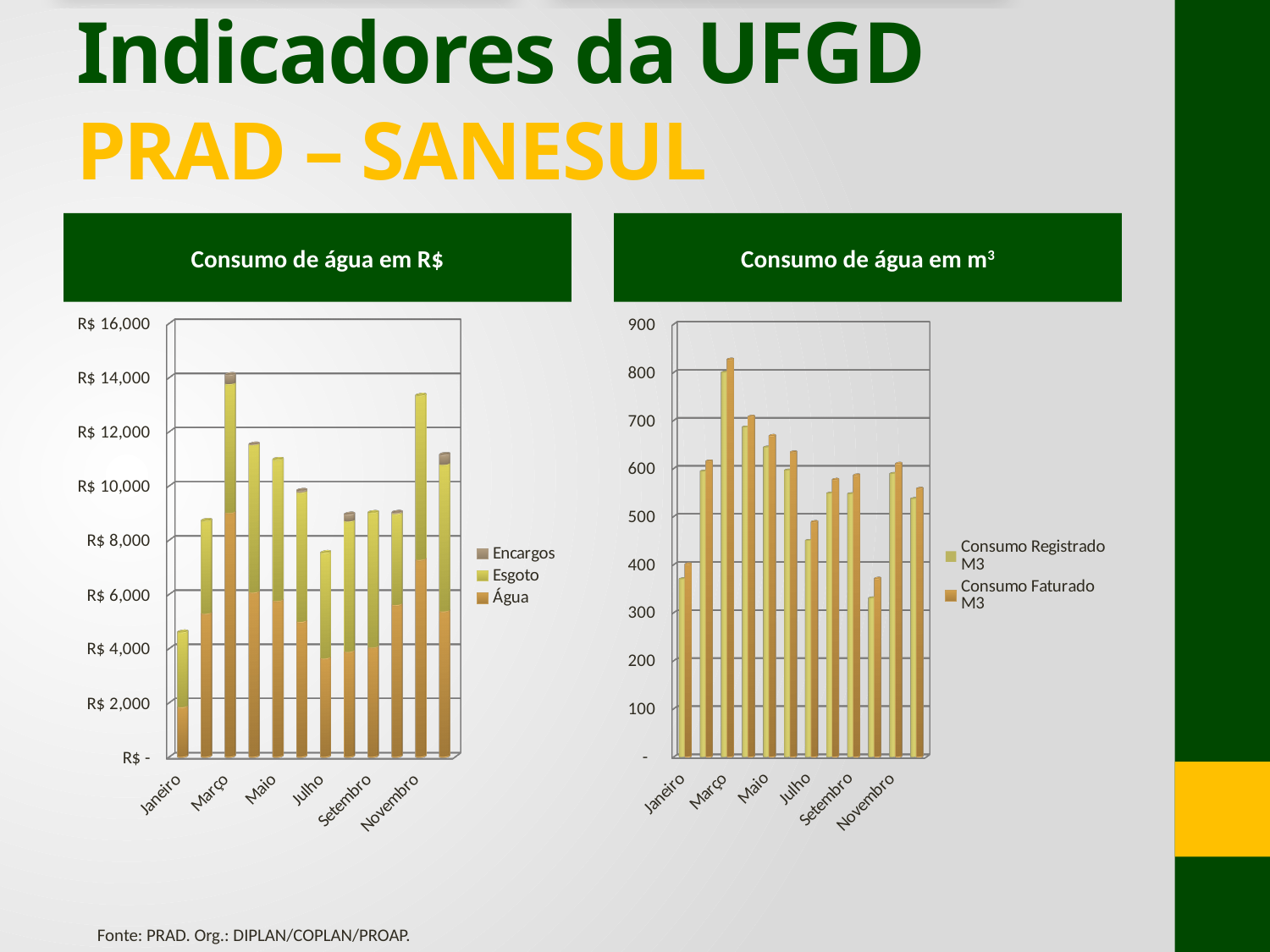
In the "Consumo de água em m³" chart, which month has the highest values? Março In the "Consumo de água em R$" chart, is the total for Janeiro greater or less than R$ 6,000? less How many series does the legend of the "Consumo de água em m³" chart list? 2 In the "Consumo de água em m³" chart, is the Consumo Registrado M3 value for Janeiro greater or less than 400? less In the "Consumo de água em R$" chart, which month has the highest total? Março In the "Consumo de água em m³" chart, which is larger for Janeiro: Consumo Registrado M3 or Consumo Faturado M3? Consumo Faturado M3 In the "Consumo de água em m³" chart, is the Consumo Registrado M3 value for Julho greater or less than 500? less What kind of chart is the "Consumo de água em R$" chart? bar chart In the "Consumo de água em R$" chart, which month has the lowest total? Janeiro How many series does the legend of the "Consumo de água em R$" chart list? 3